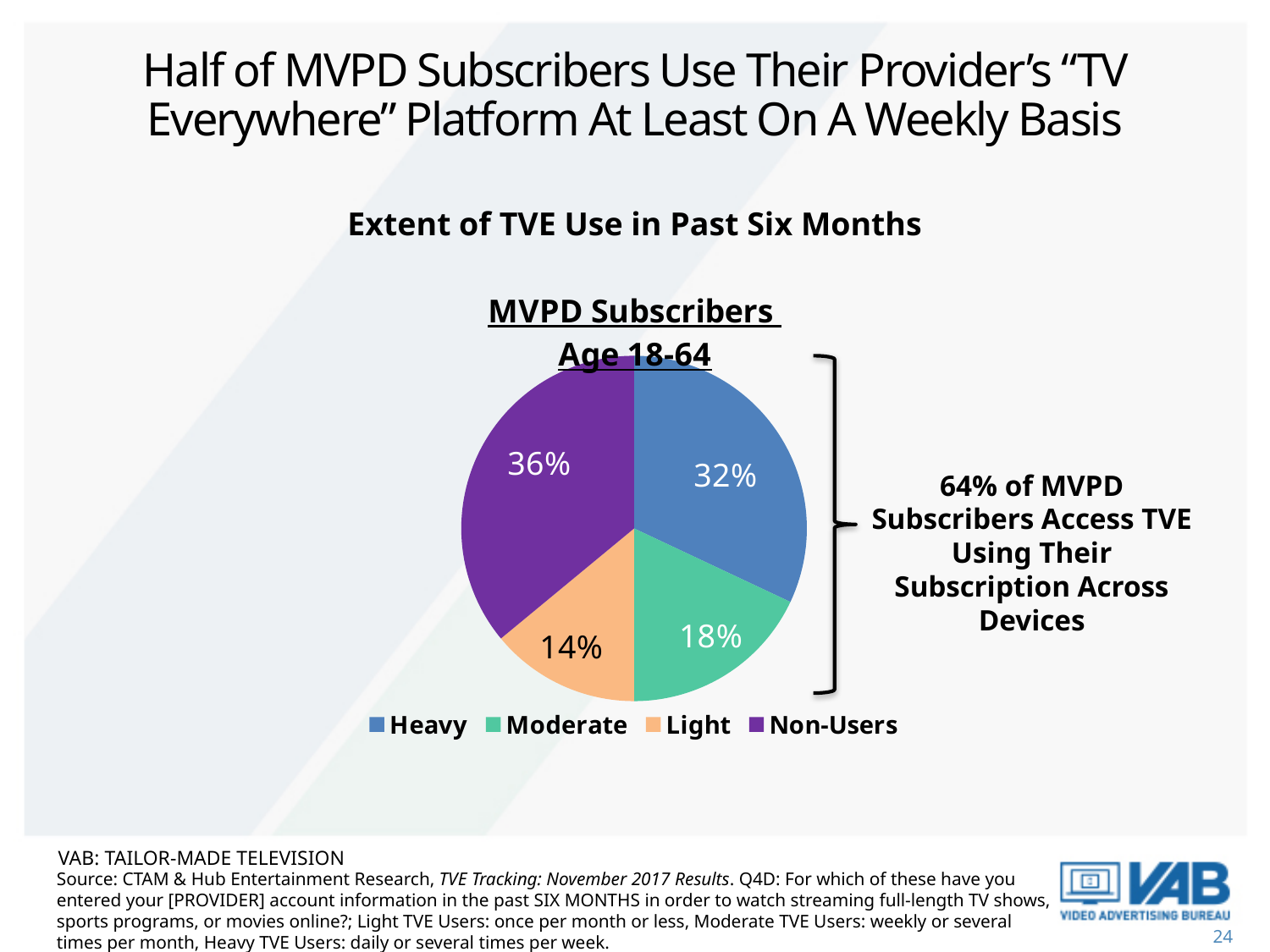
What colour is the Non-Users slice of the pie? Purple What share of MVPD subscribers age 18-64 are Moderate TVE users? 18% What share of MVPD subscribers age 18-64 are Heavy TVE users? 32% Which slice is larger, Moderate or Light? Moderate What is the combined share of Heavy, Moderate and Light TVE users? 64% How many categories does the pie chart show? 4 What is the difference in percentage points between the Non-Users slice and the Heavy slice? 4 Which category has the smallest slice of the pie? Light What share of MVPD subscribers age 18-64 are Light TVE users? 14% Which category has the largest slice of the pie? Non-Users What share of MVPD subscribers age 18-64 are Non-Users of TVE? 36% What kind of chart is shown on the slide? Pie chart